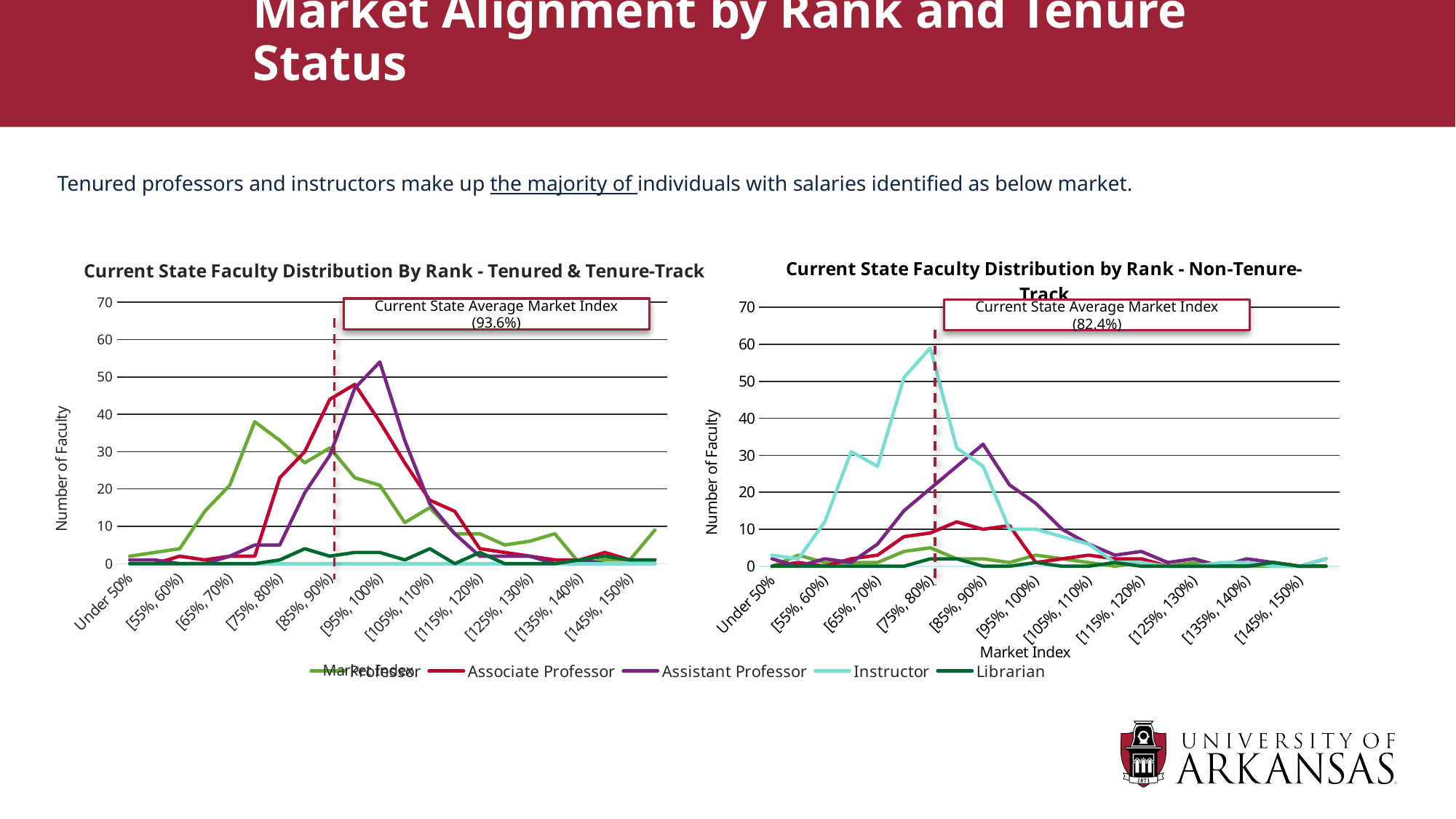
What type of chart is the 'Current State Faculty Distribution By Rank - Tenured & Tenure-Track' chart? line chart In the 'Current State Faculty Distribution By Rank - Tenured & Tenure-Track' chart, is the peak value of the Assistant Professor line greater or less than 50? greater In the 'Current State Faculty Distribution By Rank - Tenured & Tenure-Track' chart, is the peak value of the Professor line greater or less than 40? less In the 'Current State Faculty Distribution by Rank - Non-Tenure-Track' chart, which line is higher at [75%, 80%): Instructor or Assistant Professor? Instructor In the 'Current State Faculty Distribution by Rank - Non-Tenure-Track' chart, is the peak value of the Instructor line greater or less than 50? greater In the 'Current State Faculty Distribution by Rank - Non-Tenure-Track' chart, which series reaches the highest peak? Instructor In the 'Current State Faculty Distribution By Rank - Tenured & Tenure-Track' chart, does the Associate Professor line rise or fall from [95%, 100%) to [115%, 120%)? fall How many series does the legend list for the charts on the slide? 5 In the 'Current State Faculty Distribution By Rank - Tenured & Tenure-Track' chart, which series reaches the highest peak? Assistant Professor In the 'Current State Faculty Distribution By Rank - Tenured & Tenure-Track' chart, what is the Current State Average Market Index shown in the annotation box? 93.6% In the 'Current State Faculty Distribution by Rank - Non-Tenure-Track' chart, what is the Current State Average Market Index shown in the annotation box? 82.4%